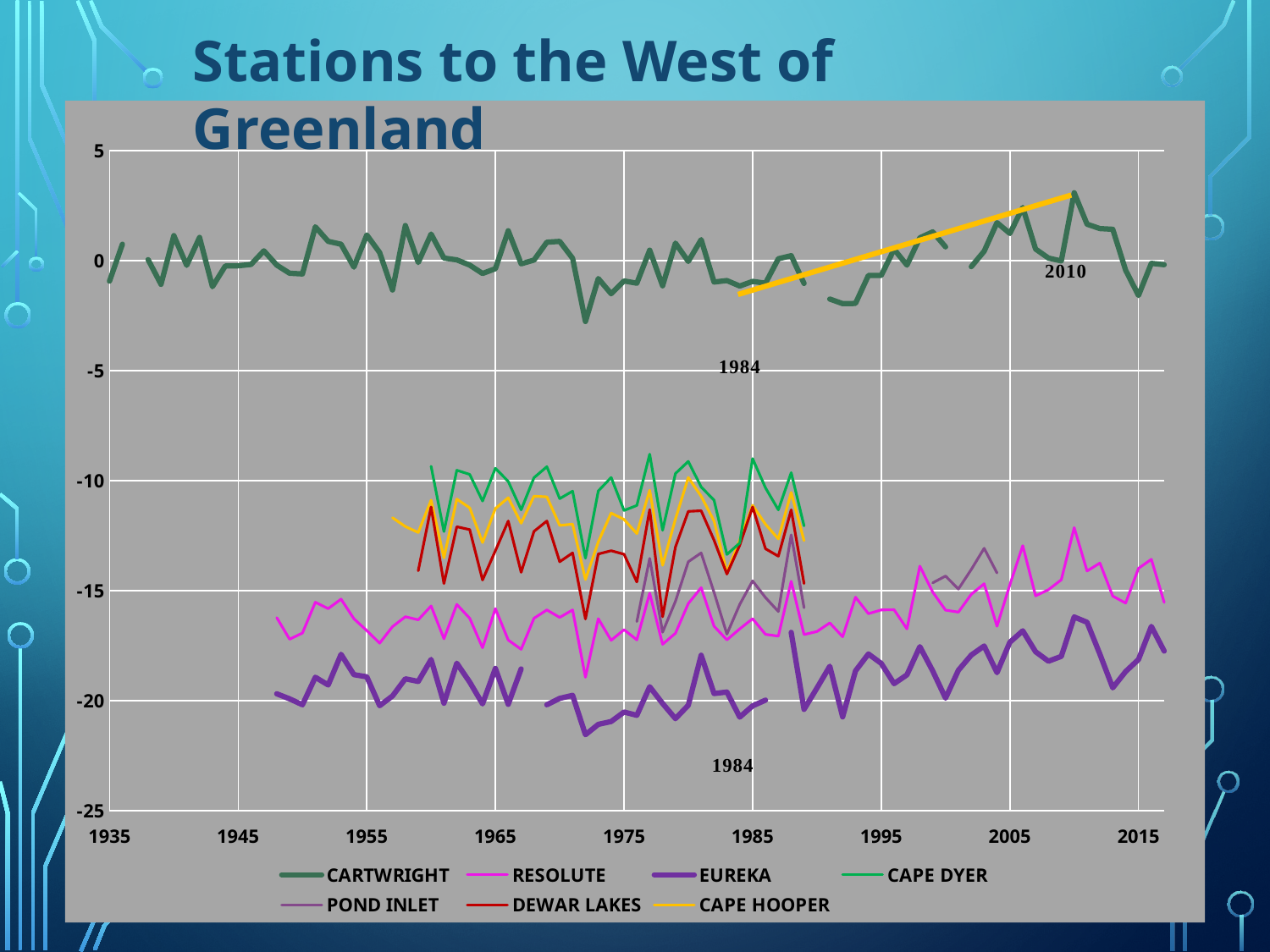
Does the yellow trend line drawn on the CARTWRIGHT series between 1984 and 2010 rise or fall? rise What colour is the EUREKA line in the legend? purple Which series has higher values, CARTWRIGHT or EUREKA? CARTWRIGHT What kind of chart is shown on the slide? line chart Which station's line is plotted highest on the chart, closest to 0? CARTWRIGHT Which station's line is plotted lowest on the chart? EUREKA Are the values for CAPE DYER greater or less than -15? greater Are the values for EUREKA greater or less than -15 throughout the series? less What is the title of the chart? Stations to the West of Greenland Are the values for CARTWRIGHT greater or less than -5 throughout the series? greater Which series has higher values, CAPE DYER or DEWAR LAKES? CAPE DYER How many series does the legend list? 7